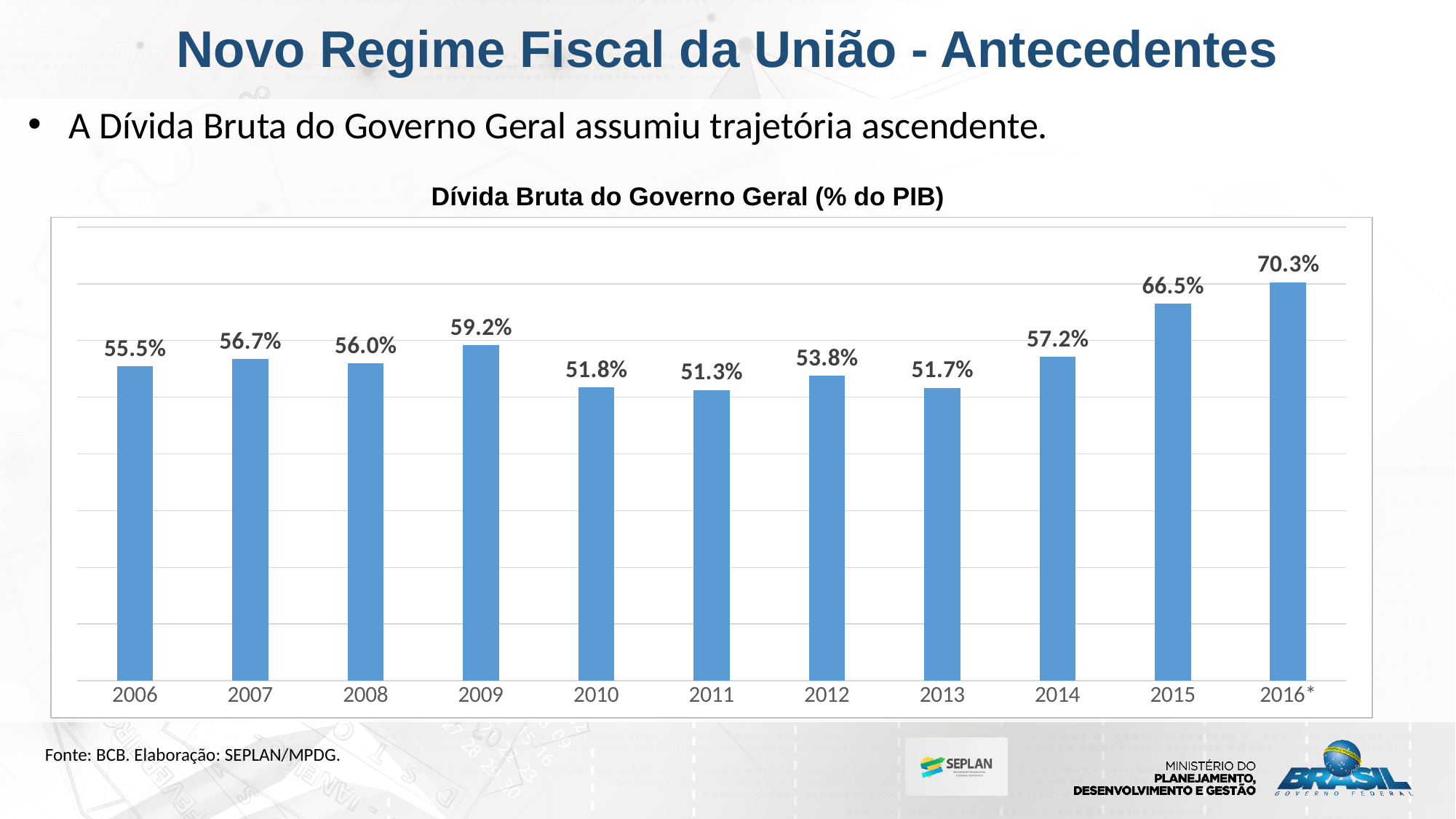
Which year has the highest value? 2016* Which is larger, the value for 2007 or the value for 2008? 2007 What is the value for 2009? 59.2% Do the values rise or fall from 2013 to 2016*? Rise What is the difference between the values for 2009 and 2010? 7.4% What is the value for 2012? 53.8% What is the title of the chart? Dívida Bruta do Governo Geral (% do PIB) How many years are shown on the x axis? 11 What is the difference between the values for 2016* and 2015? 3.8% What kind of chart is this? Bar chart What is the value for 2016*? 70.3% Which year has the lowest value? 2011